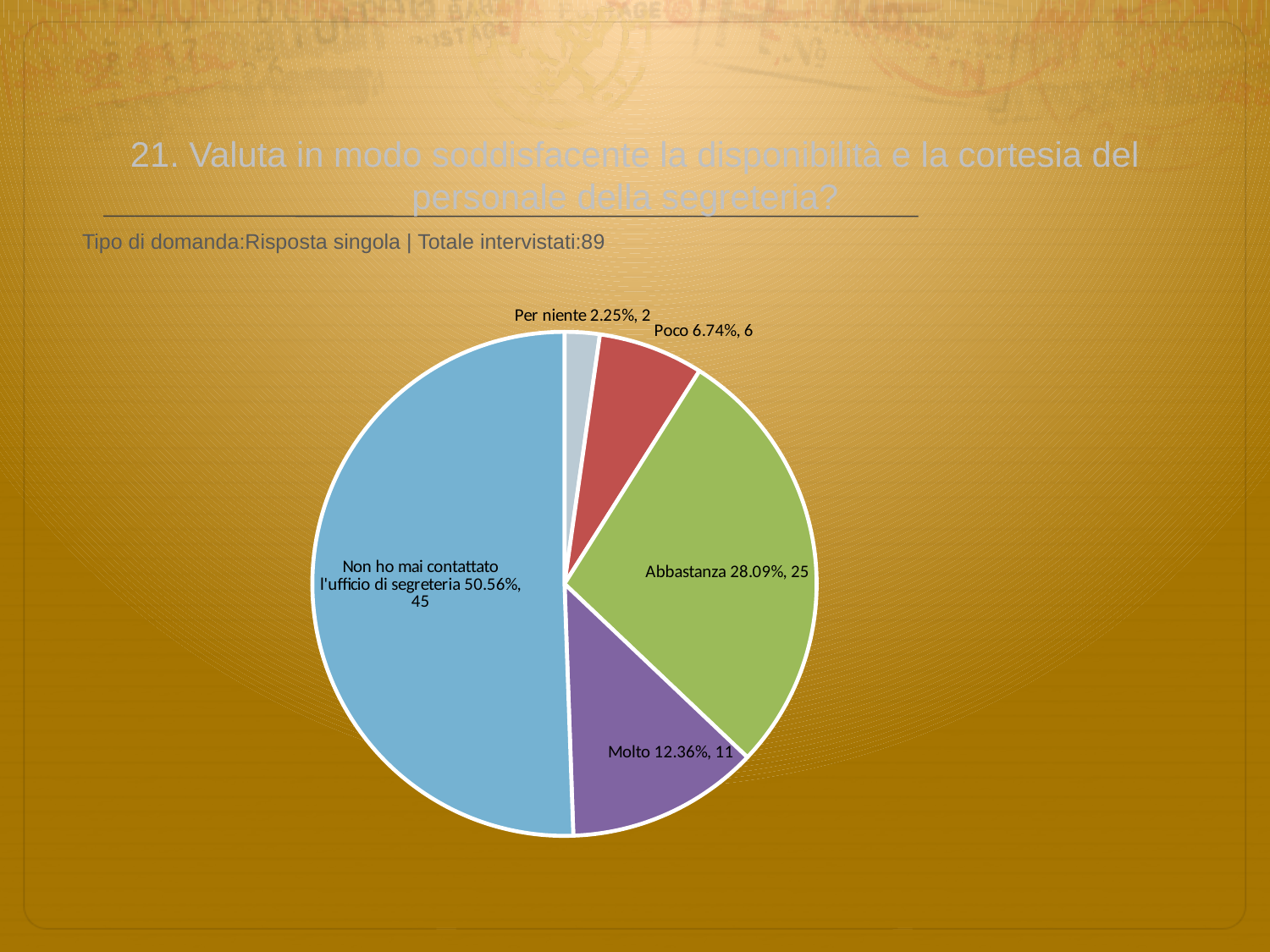
Which category has the smallest slice of the pie? Per niente What percentage share does the 'Abbastanza' slice have? 28.09% What colour is the 'Abbastanza' slice? green Which has more respondents, 'Poco' or 'Per niente'? Poco How many respondents chose 'Poco'? 6 What is the difference in respondent count between 'Abbastanza' and 'Molto'? 14 What kind of chart is shown on the slide? pie chart How many slices does the pie chart have? 5 What is the total number of respondents (Totale intervistati) stated on the slide? 89 What percentage share does the 'Non ho mai contattato l'ufficio di segreteria' slice have? 50.56% Which category has the largest slice of the pie? Non ho mai contattato l'ufficio di segreteria How many respondents chose 'Molto'? 11